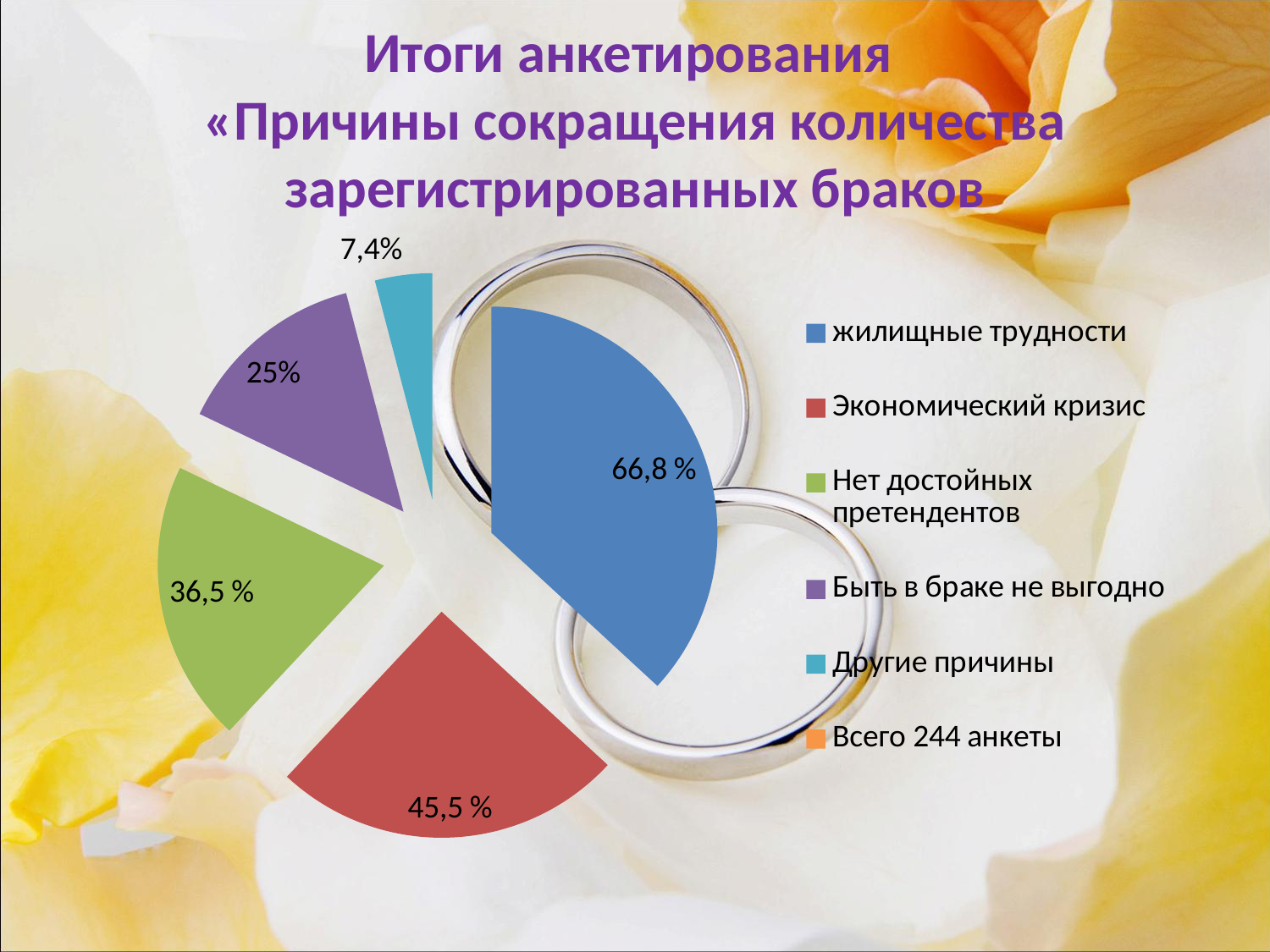
What kind of chart is shown on the slide? pie chart Which category has the largest slice in the pie chart? жилищные трудности What value is labelled on the slice for Нет достойных претендентов? 36,5 % What value is labelled on the slice for Экономический кризис? 45,5 % Which is larger, the slice for Экономический кризис or the slice for Нет достойных претендентов? Экономический кризис What value is labelled on the slice for Другие причины? 7,4% What colour is the slice for Быть в браке не выгодно? purple How many slices does the pie chart have? 5 What value is labelled on the slice for Быть в браке не выгодно? 25% Which category has the smallest slice in the pie chart? Другие причины How many entries does the legend list? 6 What value is labelled on the slice for жилищные трудности? 66,8 %